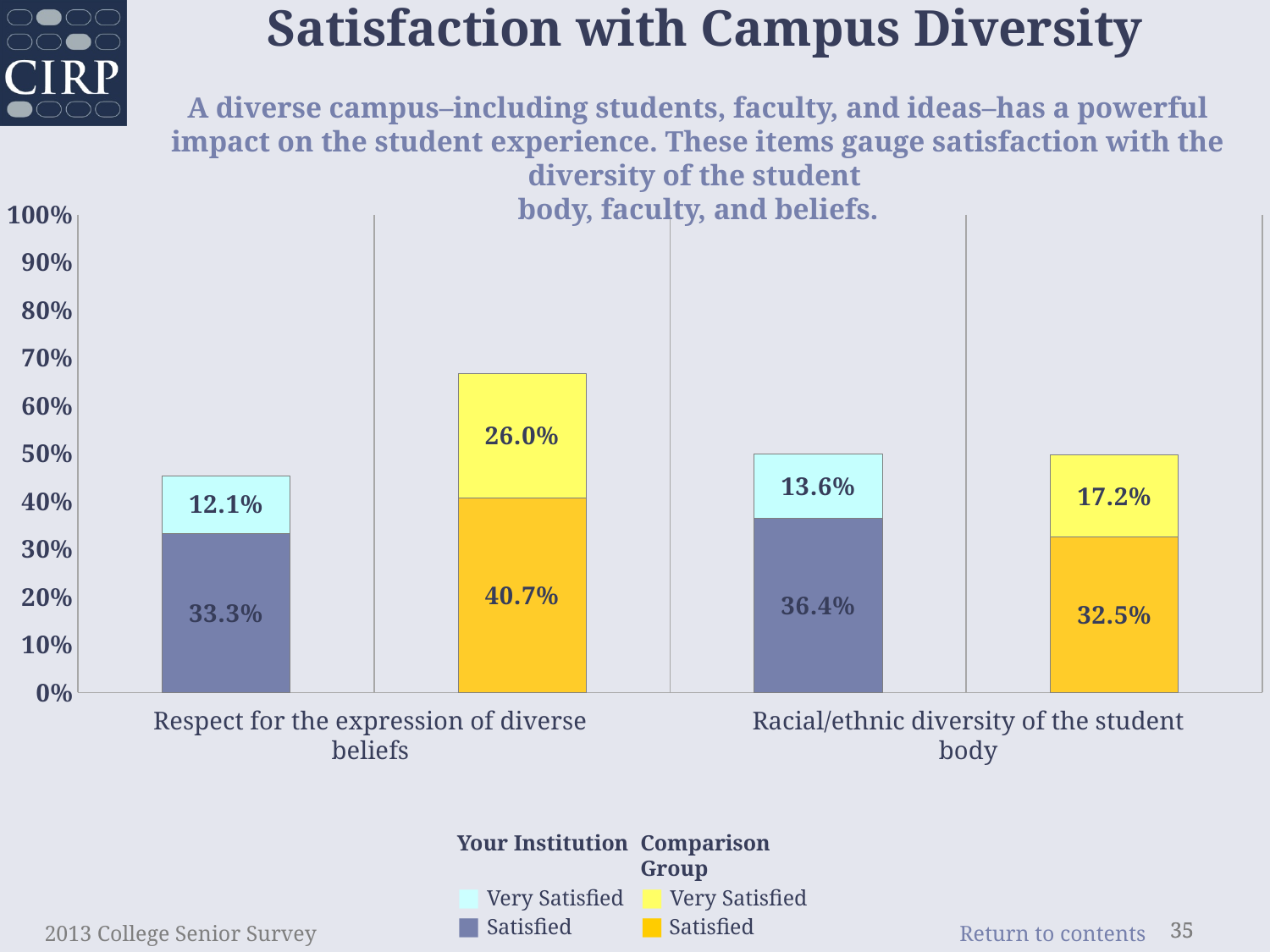
What percentage of the Comparison Group were Very Satisfied with the racial/ethnic diversity of the student body? 17.2% What percentage of the Comparison Group were Satisfied with respect for the expression of diverse beliefs? 40.7% What is the total of the Comparison Group stacked bar for respect for the expression of diverse beliefs? 66.7% What percentage of Your Institution students were Very Satisfied with respect for the expression of diverse beliefs? 12.1% Which of the four stacked bars reaches the highest total? Comparison Group, respect for the expression of diverse beliefs What kind of chart is shown on the slide? Stacked bar chart How many entries does the legend list? 4 How many categories are shown on the x axis? 2 What is the difference between the Comparison Group and Your Institution Very Satisfied values for respect for the expression of diverse beliefs? 13.9% What percentage of Your Institution students were Satisfied with the racial/ethnic diversity of the student body? 36.4% Which is larger for racial/ethnic diversity of the student body: the Satisfied value for Your Institution or for the Comparison Group? Your Institution What is the total of the Your Institution stacked bar for racial/ethnic diversity of the student body? 50.0%